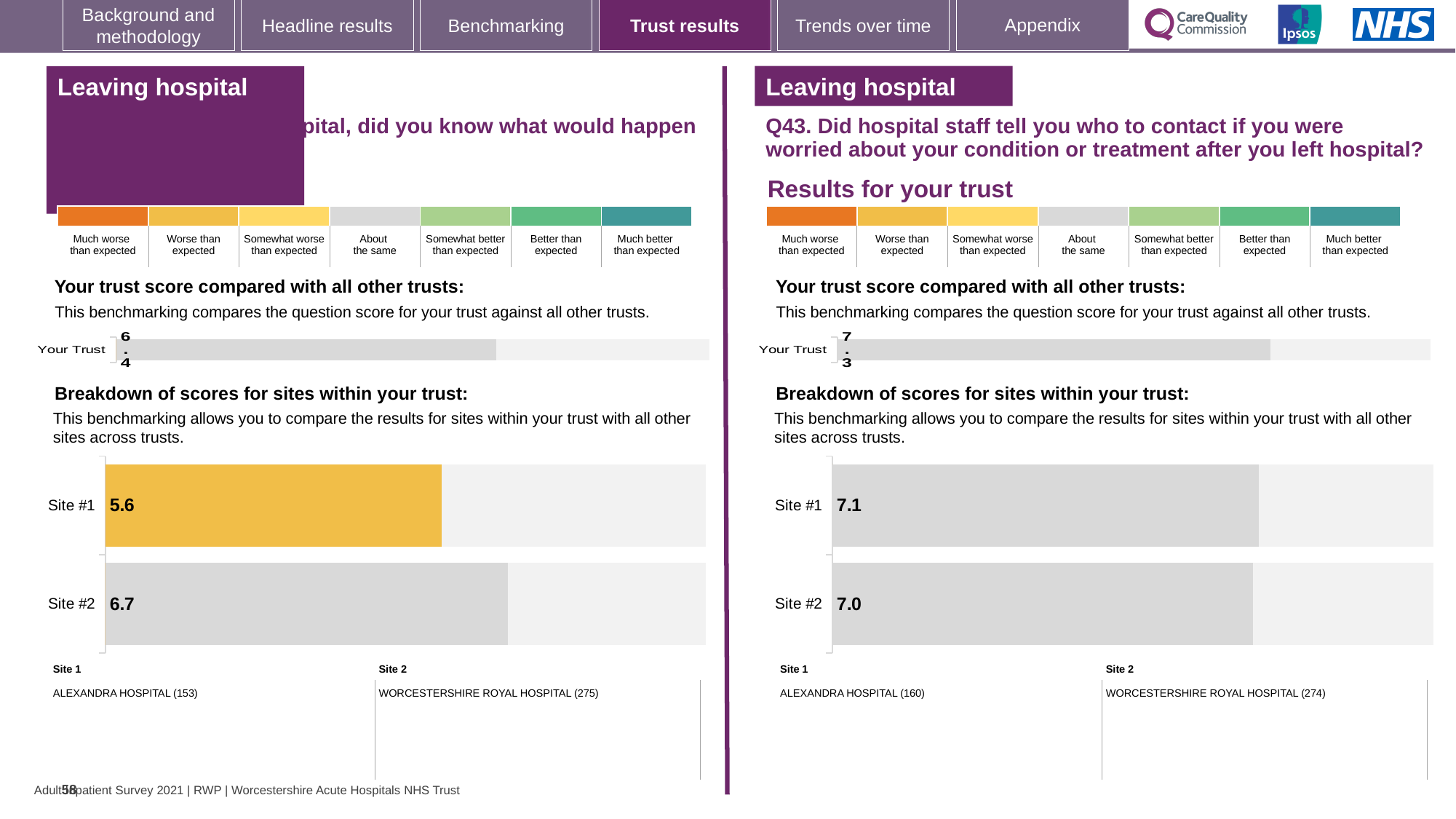
How many sites are shown on the Q43 site breakdown chart? 2 On the left-hand site breakdown chart, what colour is the bar for Site #1? Yellow/orange On the left-hand 'Breakdown of scores for sites within your trust' chart, what is the score for Site #2? 6.7 What type of chart is the Q43 'Breakdown of scores for sites within your trust' chart? Bar chart On the left-hand site breakdown chart, what is the difference between the Site #2 and Site #1 scores? 1.1 On the left-hand 'Breakdown of scores for sites within your trust' chart, what is the score for Site #1? 5.6 On the Q43 'Breakdown of scores for sites within your trust' chart, what is the score for Site #2? 7.0 On the left-hand 'Your trust score compared with all other trusts' chart, what is the score shown for Your Trust? 6.4 On the left-hand site breakdown chart, which site has the higher score? Site #2 On the Q43 site breakdown chart, what is the difference between the Site #1 and Site #2 scores? 0.1 On the Q43 'Breakdown of scores for sites within your trust' chart, what is the score for Site #1? 7.1 On the Q43 'Your trust score compared with all other trusts' chart, what is the score shown for Your Trust? 7.3